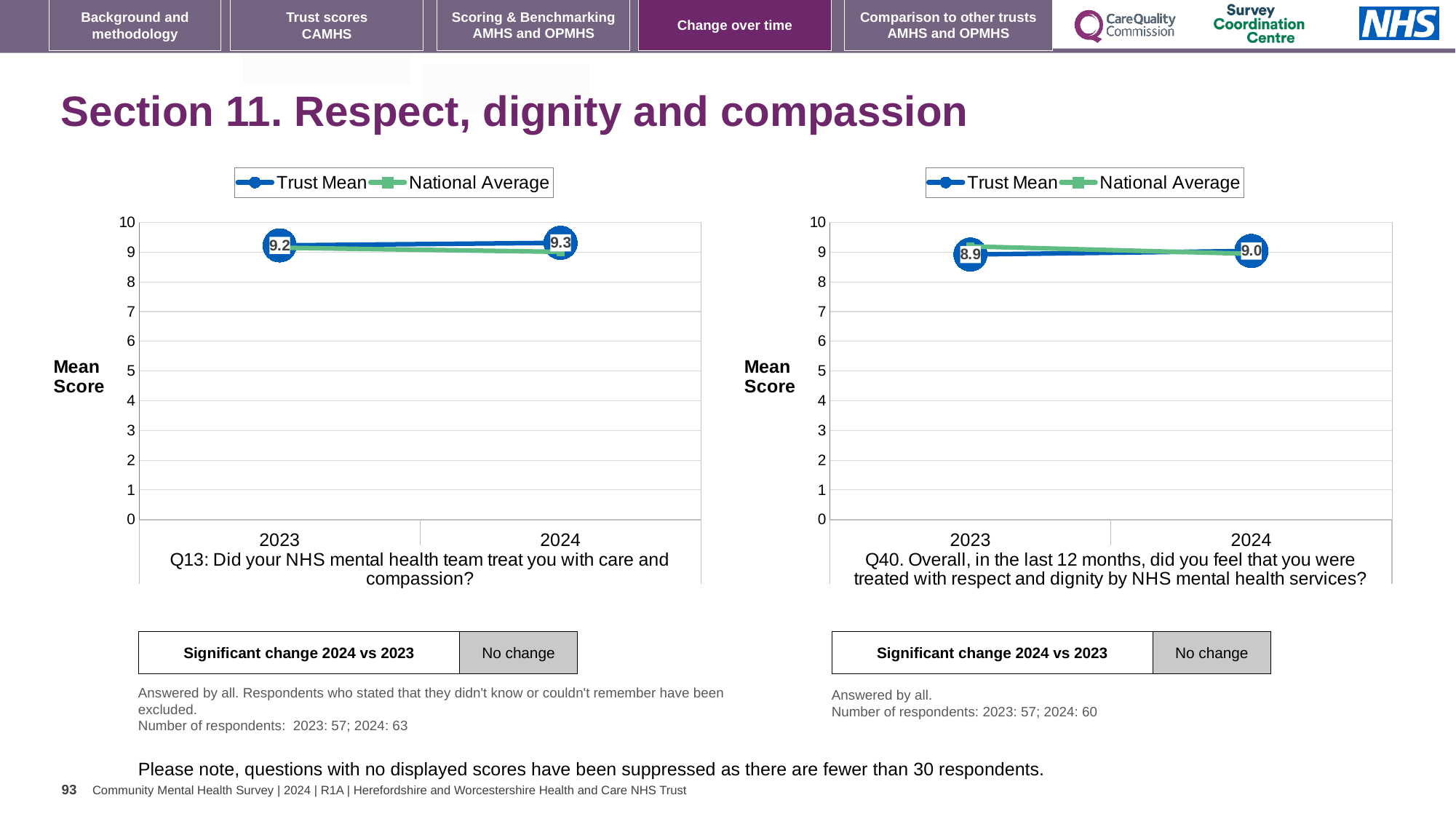
On the Q13 chart (left), what is the Trust Mean for 2023? 9.2 On the Q40 chart (right), does the Trust Mean rise or fall from 2023 to 2024? rise On the Q13 chart (left), is the National Average for 2024 greater or less than 8? greater On the Q40 chart (right), what is the Trust Mean for 2023? 8.9 On the Q13 chart (left), by how much did the Trust Mean change from 2023 to 2024? 0.1 What is the y-axis label on the Q40 chart (right)? Mean Score On the Q13 chart (left), what is the Trust Mean for 2024? 9.3 What kind of chart is the Q13 chart on the left? line chart On the Q40 chart (right), which year has the higher Trust Mean, 2023 or 2024? 2024 How many years are shown on the x axis of the Q13 chart (left)? 2 On the Q40 chart (right), what is the Trust Mean for 2024? 9.0 How many series does the legend of the Q40 chart (right) list? 2